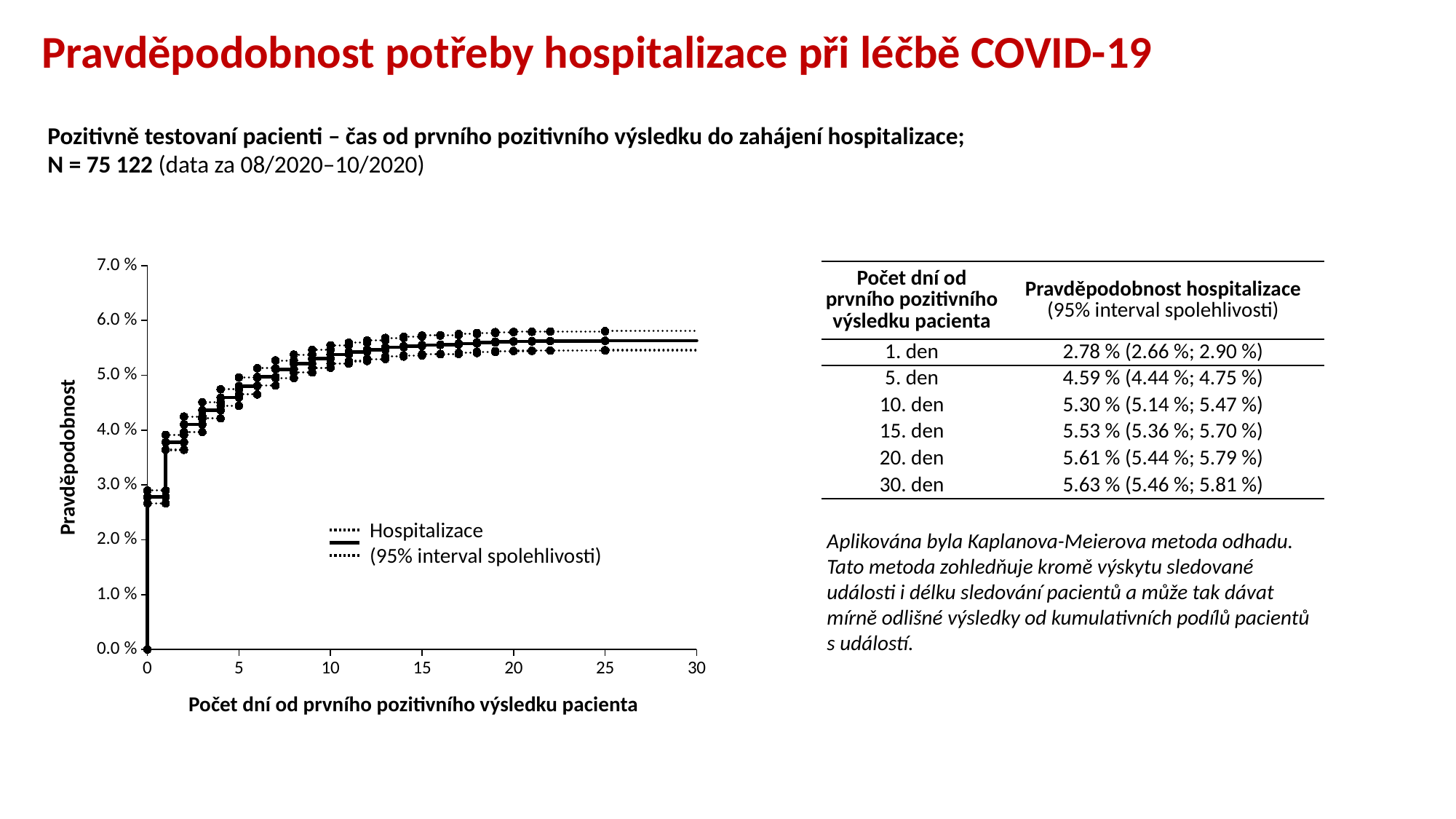
Is the value of the curve at day 2 greater or less than 5.0 %? less Is the value of the curve at day 20 greater or less than 5.0 %? greater According to the table, what is the probability of hospitalization on day 10 (10. den)? 5.30 % What is the label of the y axis of the chart? Pravděpodobnost What is the difference between the probability of hospitalization on day 30 and on day 1? 2.85 % Which is larger: the probability of hospitalization on day 15 or on day 5? 15. den Which day listed in the table has the highest probability of hospitalization? 30. den What kind of chart is shown on the slide? line chart Does the hospitalization probability rise or fall as the number of days increases? rises What is the 95% confidence interval for the probability of hospitalization on day 15 (15. den)? (5.36 %; 5.70 %) Which day listed in the table has the lowest probability of hospitalization? 1. den According to the table, what is the probability of hospitalization on day 20 (20. den)? 5.61 %